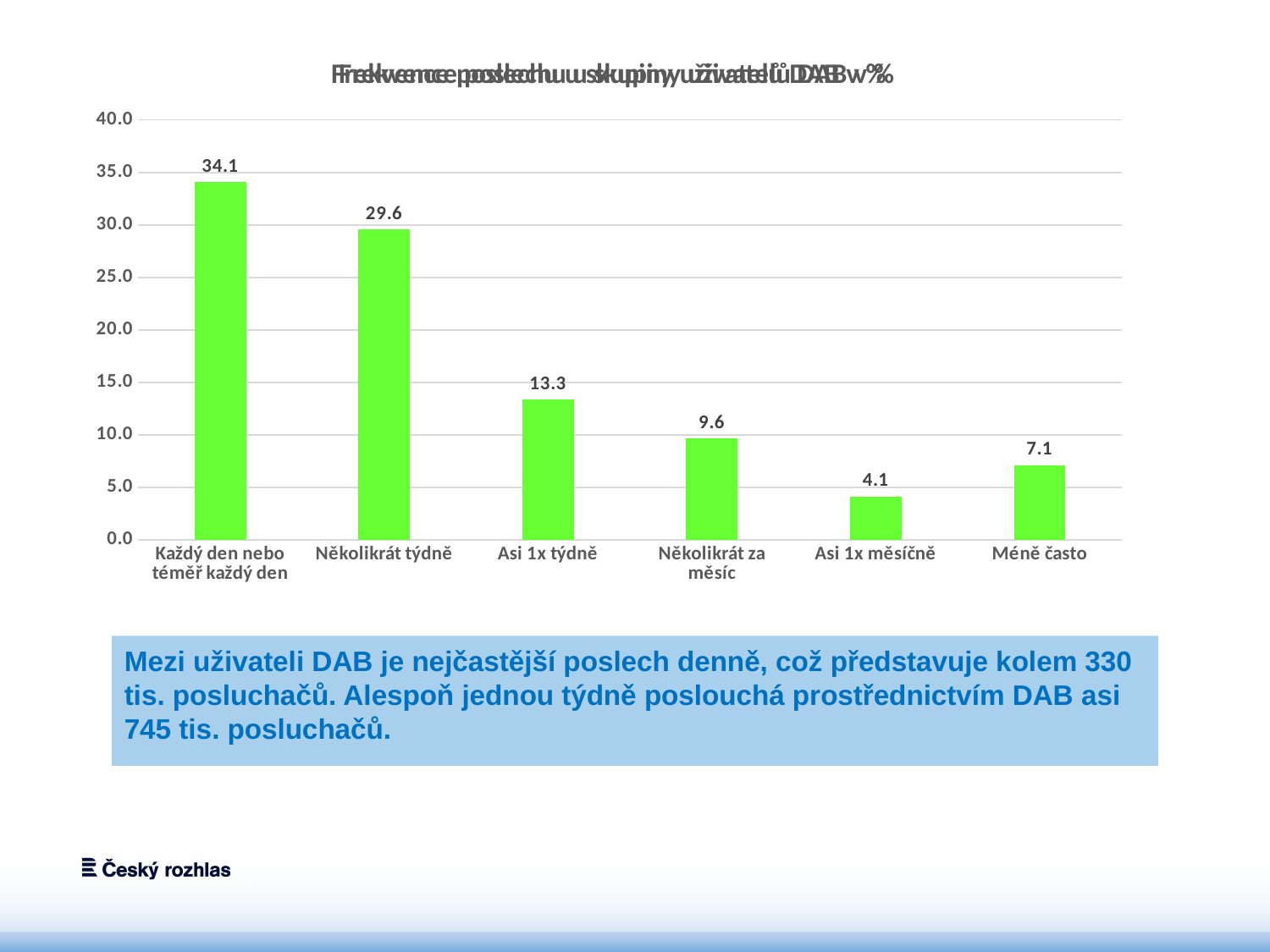
What is the value for "Několikrát týdně"? 29.6 What is the value for "Méně často"? 7.1 What is the value for "Každý den nebo téměř každý den"? 34.1 What kind of chart is shown on the slide? bar chart Which is larger, the value for "Asi 1x týdně" or the value for "Několikrát za měsíc"? Asi 1x týdně What is the value for "Asi 1x týdně"? 13.3 What is the difference between the values for "Několikrát za měsíc" and "Asi 1x měsíčně"? 5.5 How many categories are shown on the x axis? 6 Which category has the highest value? Každý den nebo téměř každý den Is the value for "Méně často" greater or less than 10.0? less What is the difference between the values for "Každý den nebo téměř každý den" and "Několikrát týdně"? 4.5 Which category has the lowest value? Asi 1x měsíčně